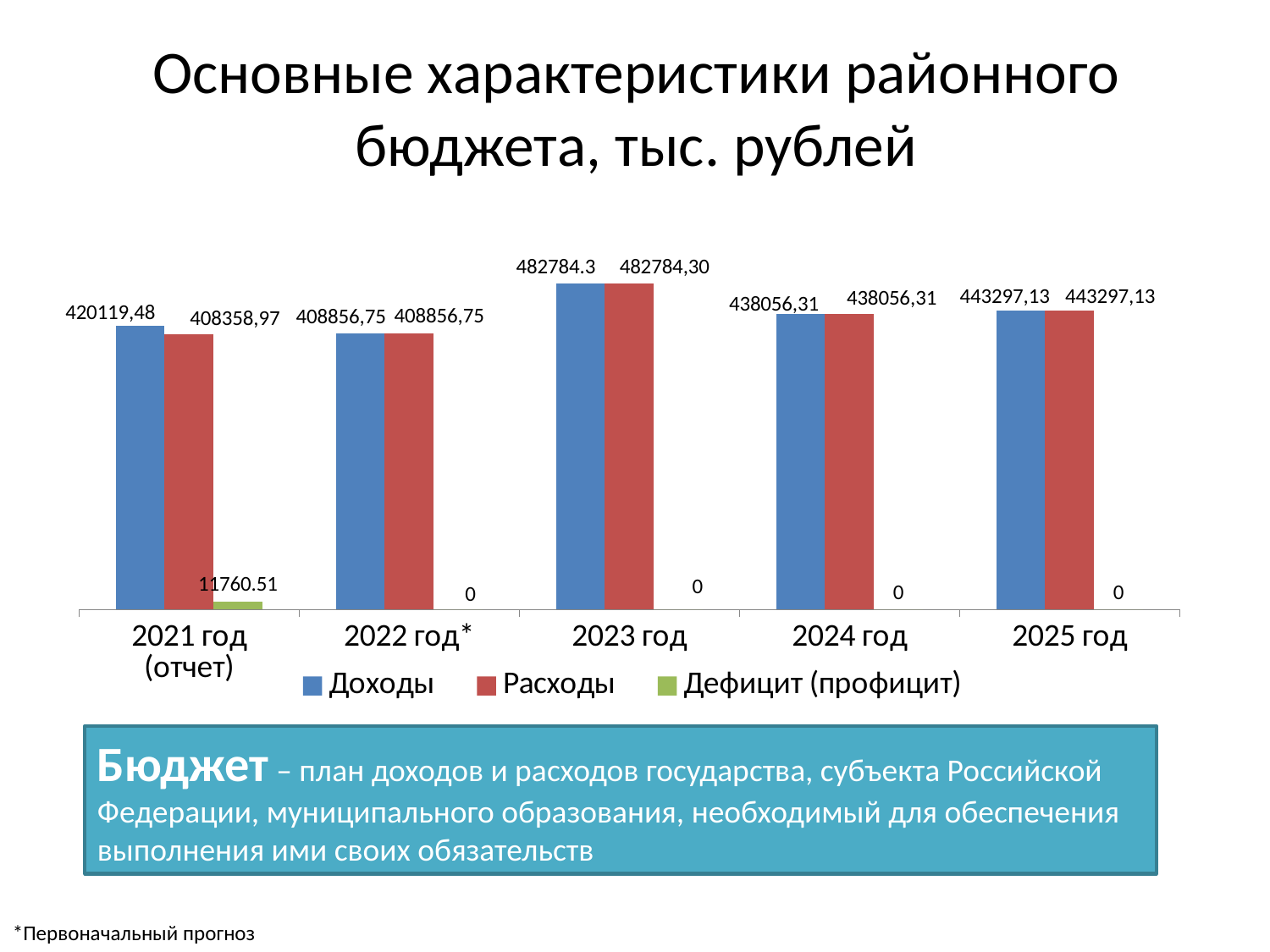
What is the value of Дефицит (профицит) for 2024 год? 0 How many year categories are shown on the x axis? 5 Which is larger: Доходы for 2024 год or Доходы for 2025 год? 2025 год What is the value of Расходы for 2023 год? 482784,30 What is the value of Доходы for 2021 год (отчет)? 420119,48 How many series does the legend list? 3 What kind of chart is shown on the slide? bar chart What is the difference between Доходы and Расходы for 2021 год (отчет)? 11760,51 Which year has the highest value of Доходы? 2023 год What is the value of Дефицит (профицит) for 2021 год (отчет)? 11760.51 Do the values of Доходы rise or fall from 2023 год to 2024 год? fall Which year has the lowest value of Расходы? 2021 год (отчет)